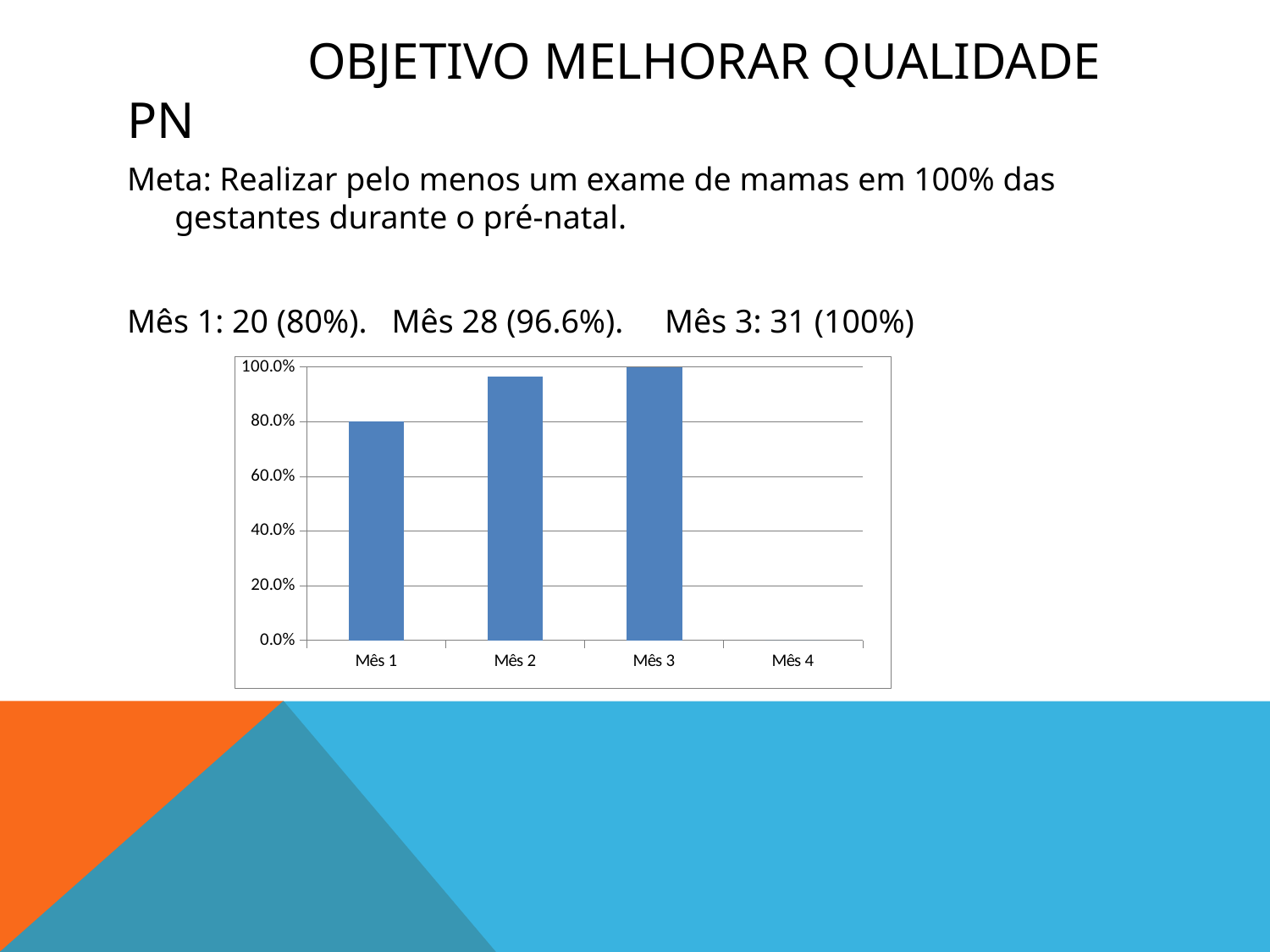
What is the difference between the values for Mês 3 and Mês 1? 20.0% What is the value for Mês 3 in the chart? 100.0% How many categories are labelled on the x axis of the chart? 4 What colour are the bars in the chart? blue Among the months that have a bar, which one has the lowest value? Mês 1 Is the value for Mês 2 greater or less than 100.0%? less Which is larger, the value for Mês 2 or the value for Mês 1? Mês 2 Which month has the tallest bar in the chart? Mês 3 Is the value for Mês 2 greater or less than 80.0%? greater What kind of chart is shown on the slide? bar chart Do the bar values rise or fall from Mês 1 to Mês 3? rise What is the value for Mês 1 in the chart? 80.0%